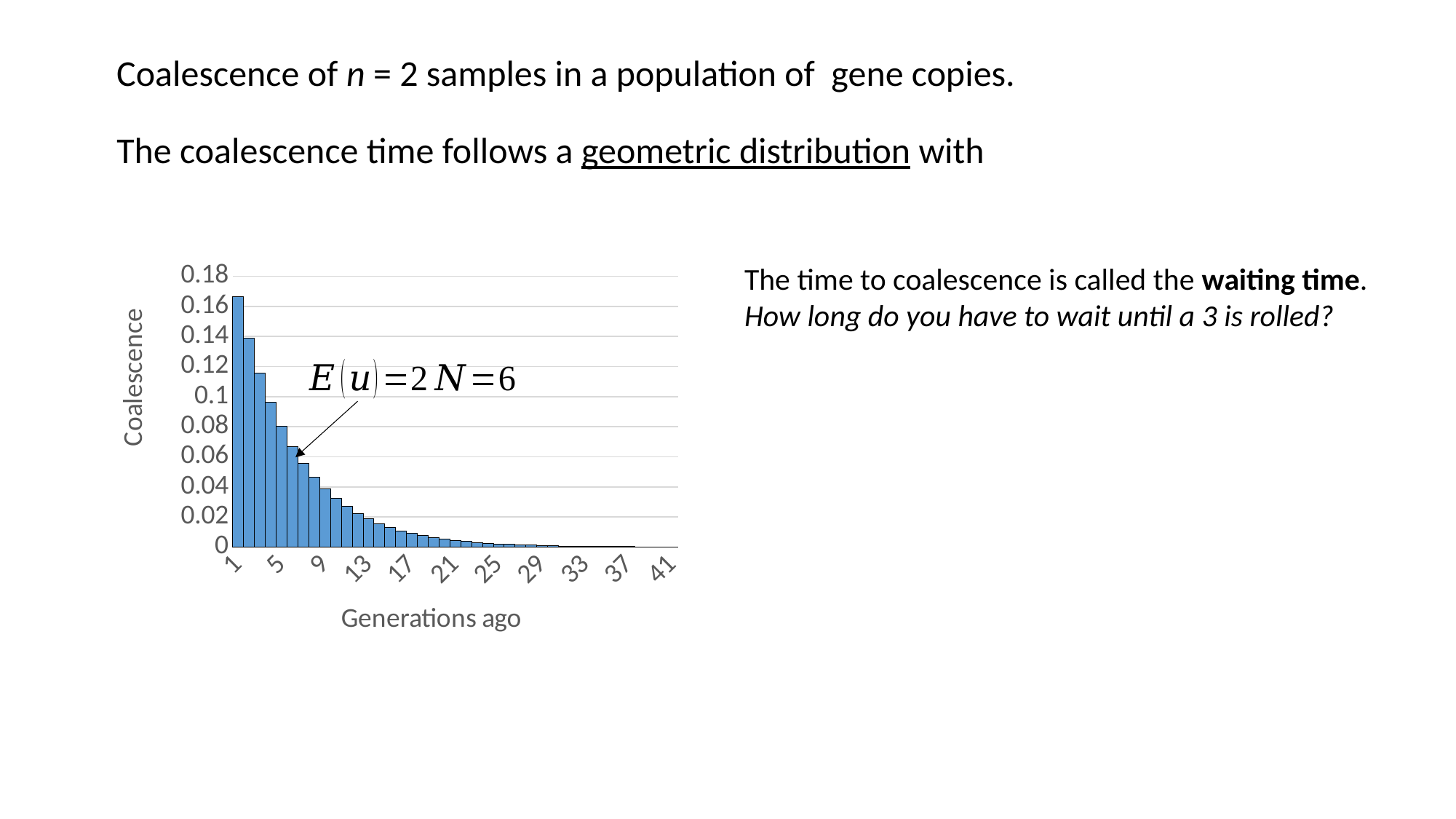
What is the label of the x axis? Generations ago Is the coalescence value for generation 5 greater or less than 0.1? less What is the label of the y axis? Coalescence Is the coalescence value for generation 17 greater or less than 0.02? less Which generation has the highest coalescence value? 1 Do the coalescence values rise or fall as generations ago increases? fall Is the coalescence value for generation 1 greater or less than 0.14? greater What kind of chart is shown on the slide? bar chart Which has a larger coalescence value, generation 1 or generation 9? generation 1 Which has a larger coalescence value, generation 5 or generation 21? generation 5